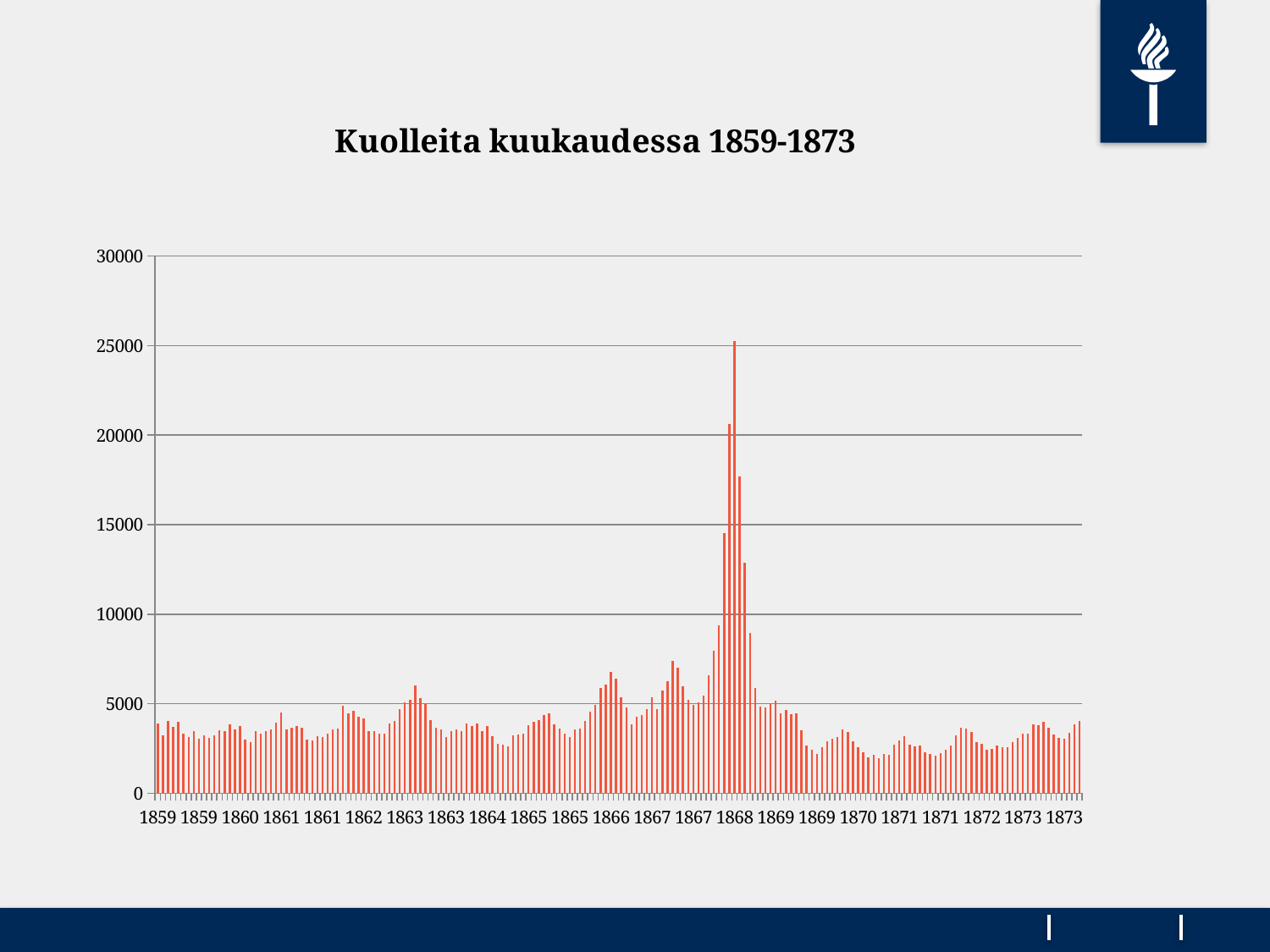
Which year is the first shown on the horizontal axis? 1859 Which year has the larger peak monthly value, 1863 or 1868? 1868 What is the title of the chart? Kuolleita kuukaudessa 1859-1873 Is the highest bar on the chart greater or less than 30000? less What is the maximum value shown on the vertical axis? 30000 Which year is the last shown on the horizontal axis? 1873 Are the monthly values in 1870 greater or less than 5000? less Is the highest bar on the chart greater or less than 20000? greater In which year does the chart reach its highest monthly value? 1868 What kind of chart is shown on the slide? bar chart